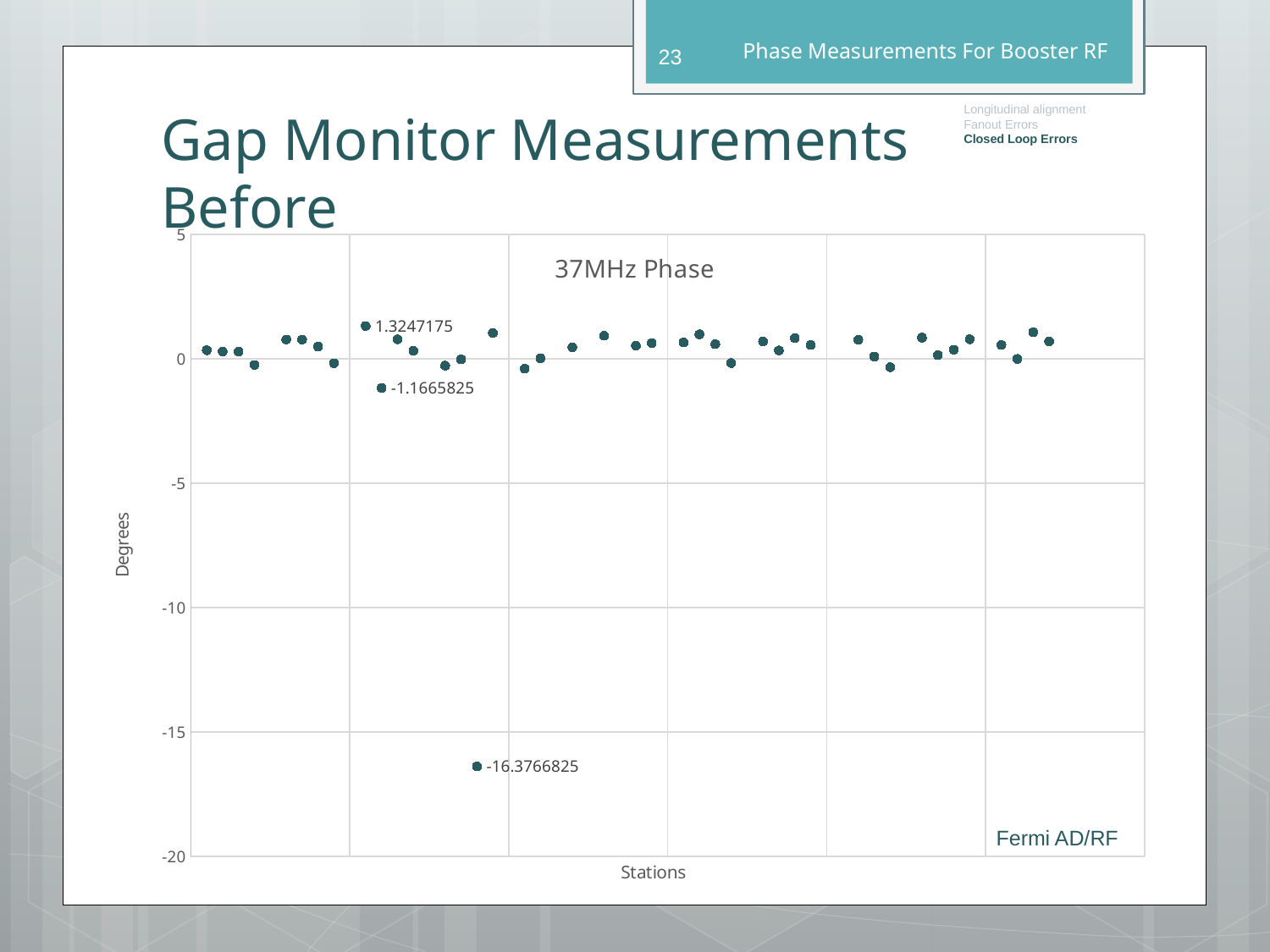
What is the value of the lowest labelled point on the chart? -16.3766825 What is the value of the highest labelled point on the chart? 1.3247175 What is the title of the chart? 37MHz Phase What is the value of the labelled point just below zero near the left of the chart? -1.1665825 What is the difference between the labelled values 1.3247175 and -1.1665825? 2.4913 Is the labelled point at 1.3247175 greater or less than 0? greater What kind of chart is shown on the slide? scatter chart Which labelled value is larger, 1.3247175 or -1.1665825? 1.3247175 Is the labelled point at -1.1665825 greater or less than -5? greater What is the difference between the labelled values 1.3247175 and -16.3766825? 17.7014 Is the lowest point on the chart greater or less than -15? less What is the label on the vertical axis of the chart? Degrees